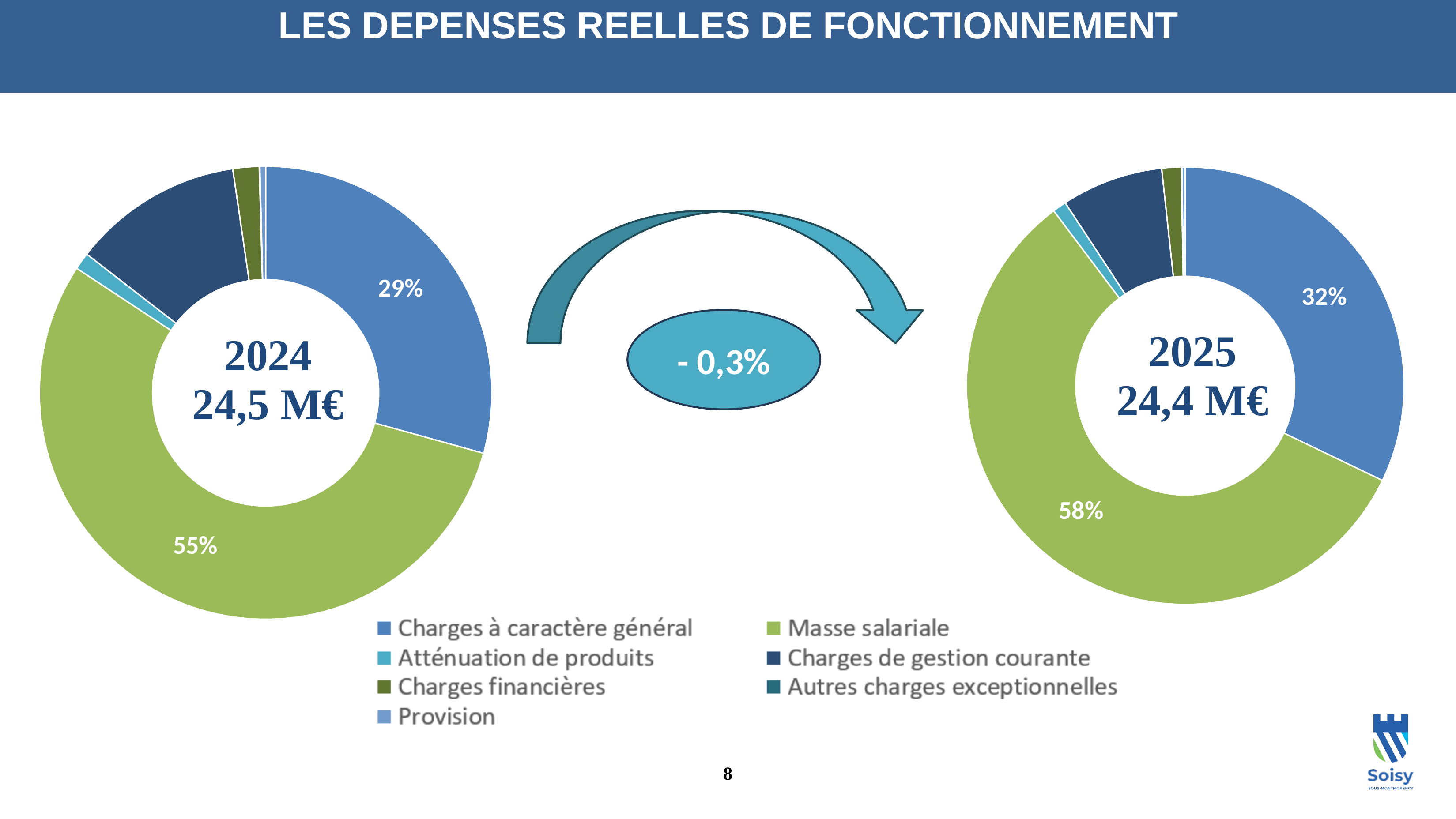
Is the share of Masse salariale larger in the 2024 chart or the 2025 chart? 2025 How many categories does the legend list? 7 What kind of chart is used for the 2024 and 2025 expenses? Pie (donut) chart By how many percentage points does the Masse salariale share in the 2025 chart exceed that in the 2024 chart? 3 What percentage change is shown between the 2024 and 2025 charts? - 0,3% In the 2024 chart, which category has the largest share? Masse salariale In the 2024 chart, what share of expenses is Masse salariale? 55% What total amount is shown in the centre of the 2024 chart? 24,5 M€ In the 2025 chart, what share of expenses is Masse salariale? 58% In the 2025 chart, what share of expenses is Charges à caractère général? 32% In the 2025 chart, which category has the largest share? Masse salariale In the 2024 chart, what share of expenses is Charges à caractère général? 29%